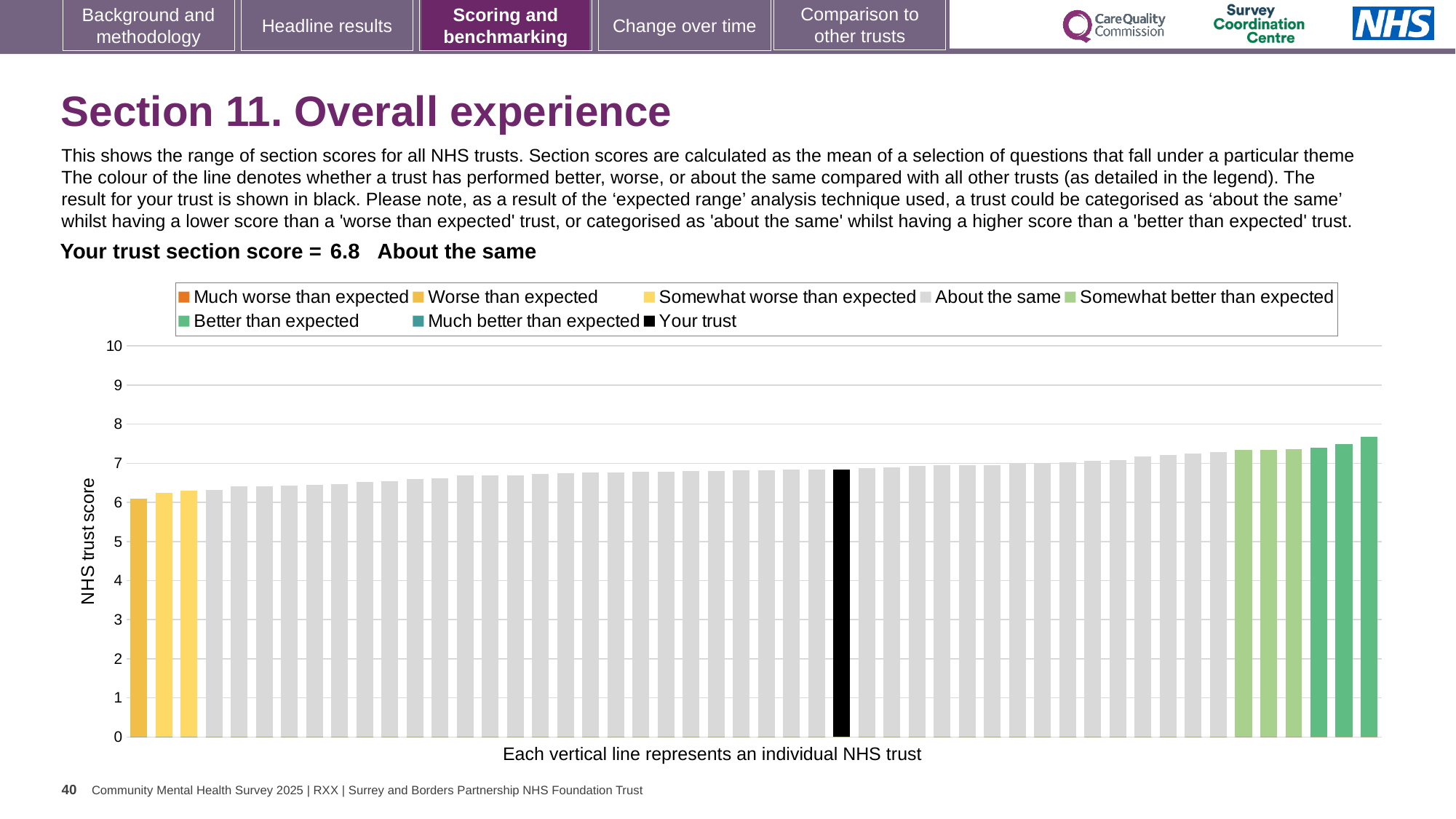
What kind of chart is shown on the slide? bar chart Which bar is higher: the black bar for your trust or the rightmost bar? the rightmost bar Do the bar values rise or fall from left to right along the x axis? rise What is the label on the y axis of the chart? NHS trust score What colour is used for the bar representing your trust? black How many entries does the chart legend list? 8 Is the value for the highest-scoring trust (rightmost bar) greater or less than 7? greater Is the value for the lowest-scoring trust (leftmost bar) greater or less than 7? less Which category is your trust placed in for this section? About the same What is the section score for your trust shown on the slide? 6.8 Is the value for your trust (the black bar) greater or less than 5? greater